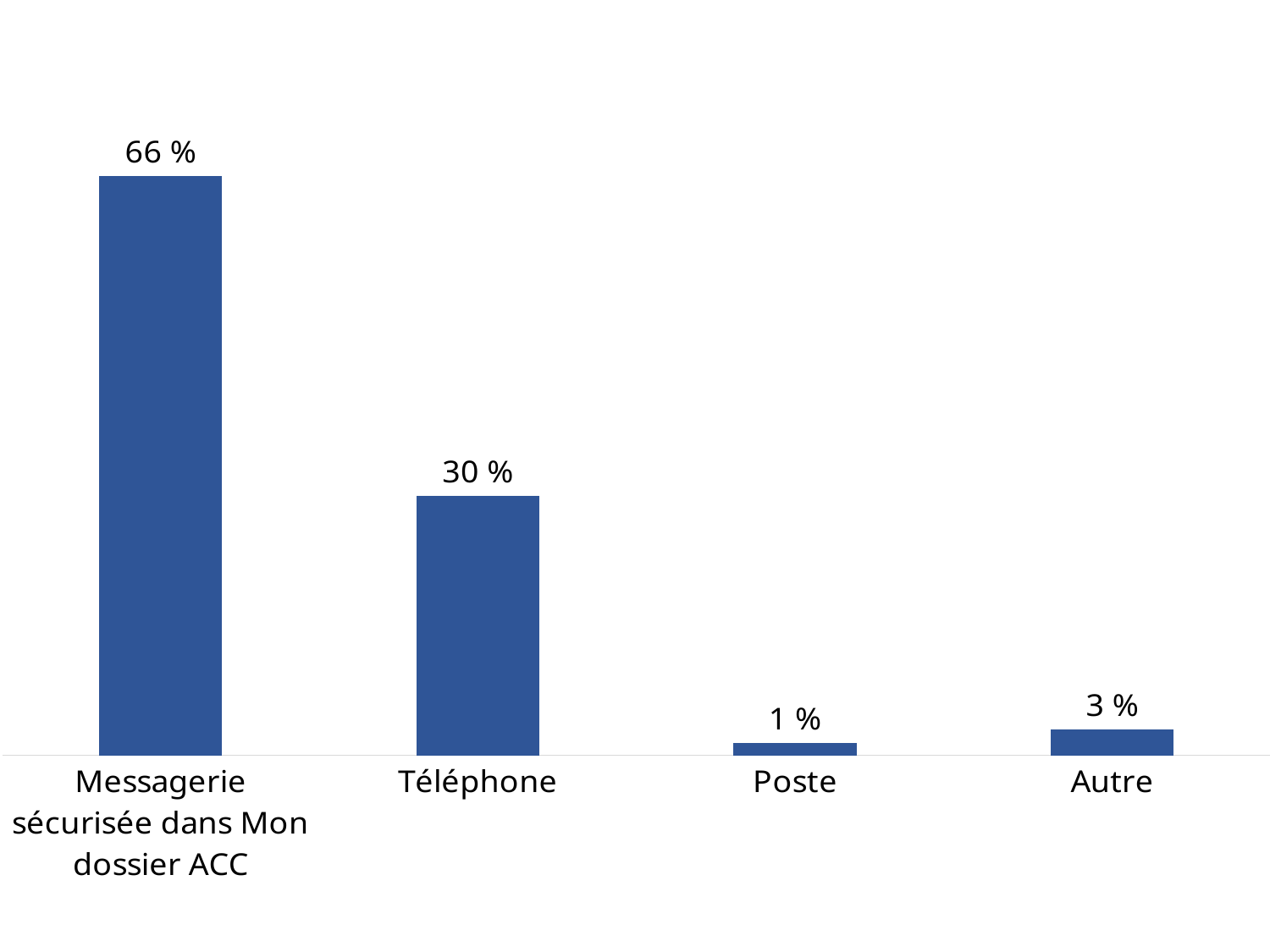
Which category has the lowest value? Poste What is the value for Messagerie sécurisée dans Mon dossier ACC? 66 % What kind of chart is shown on the slide? Bar chart How many categories are shown on the chart? 4 What is the value for Poste? 1 % What is the value for Autre? 3 % What colour are the bars in the chart? Blue What is the difference between the values for Autre and Poste? 2 % Which category has the highest value? Messagerie sécurisée dans Mon dossier ACC What is the value for Téléphone? 30 % Which is larger, the value for Téléphone or the value for Autre? Téléphone What is the difference between the values for Messagerie sécurisée dans Mon dossier ACC and Téléphone? 36 %